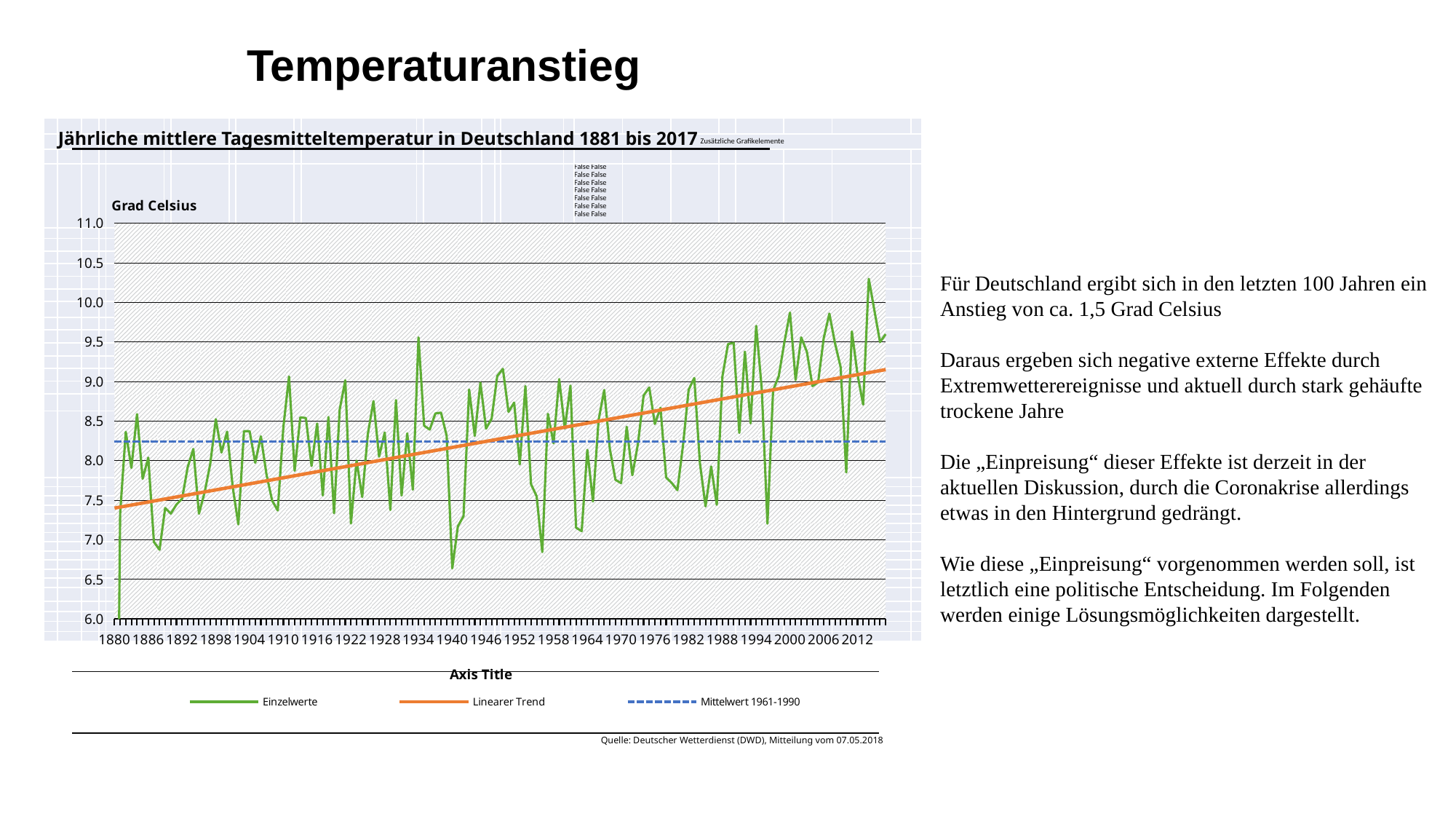
What unit is shown as the label of the vertical axis? Grad Celsius Does the Linearer Trend series rise or fall from 1880 to 2017? rise What kind of chart is shown on the slide? line chart Is the value of the Mittelwert 1961-1990 line greater or less than 8.5? less Which series is drawn as a dashed line? Mittelwert 1961-1990 Is the Linearer Trend value at 2012 greater or less than 9.0? greater Does the Einzelwerte series ever exceed 10.0 Grad Celsius? yes Which is larger, the Linearer Trend value at 1880 or at 2012? 2012 How many series does the legend list? 3 What is the title of the chart? Jährliche mittlere Tagesmitteltemperatur in Deutschland 1881 bis 2017